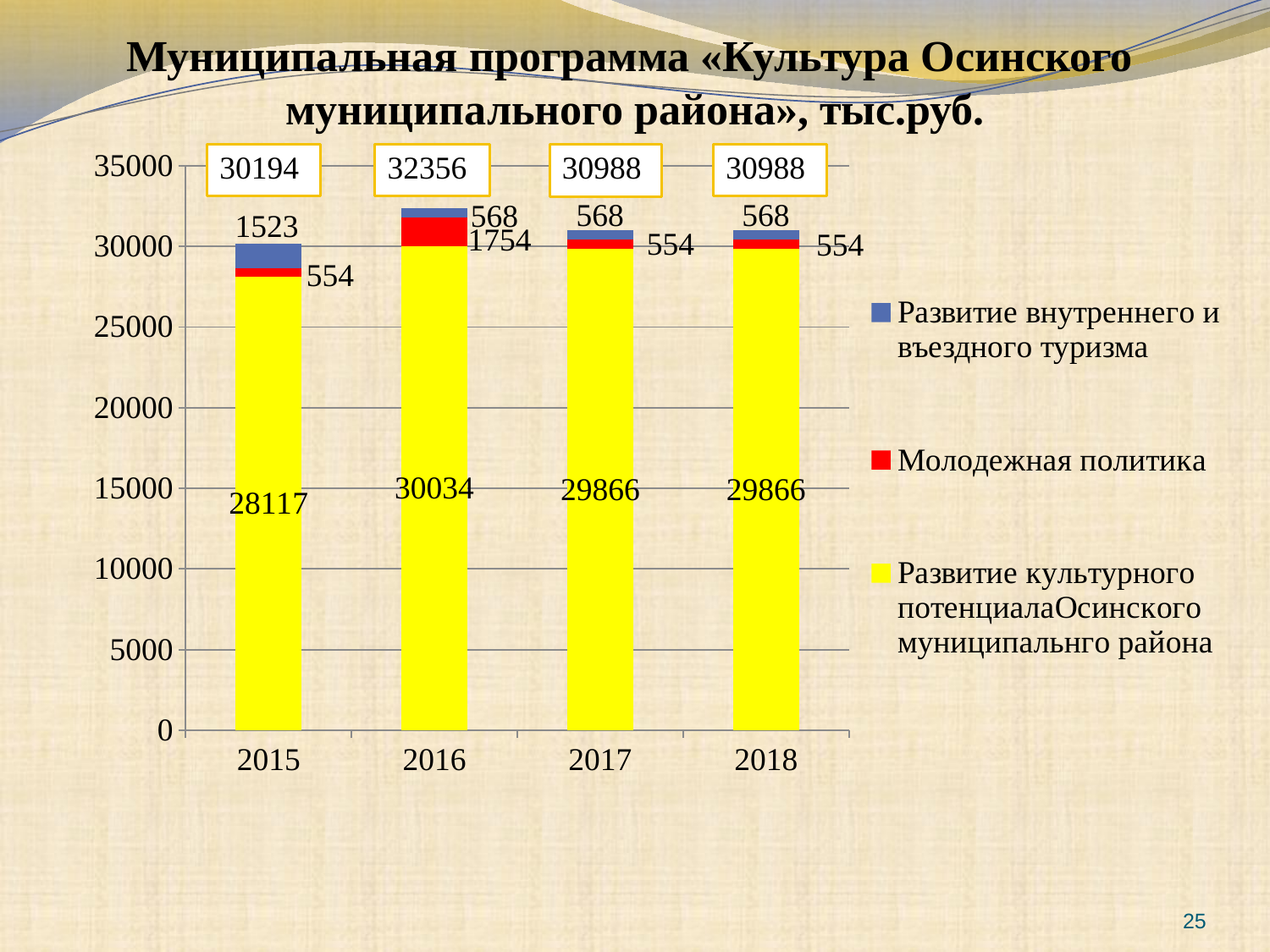
What kind of chart is shown on the slide? stacked bar chart How many series does the legend list? 3 What is the total of the stacked bar for 2018? 30988 Which is larger: the «Молодежная политика» value in 2016 or in 2017? 2016 Which year has the highest total? 2016 What is the difference between the «Развитие культурного потенциала Осинского муниципальнго района» values for 2016 and 2015? 1917 What is the value for «Развитие культурного потенциала Осинского муниципальнго района» in 2015? 28117 Which year has the lowest total? 2015 What is the value for «Развитие внутреннего и въездного туризма» in 2015? 1523 What is the total of the stacked bar for 2016? 32356 What is the value for «Молодежная политика» in 2016? 1754 How many years are shown on the x axis? 4